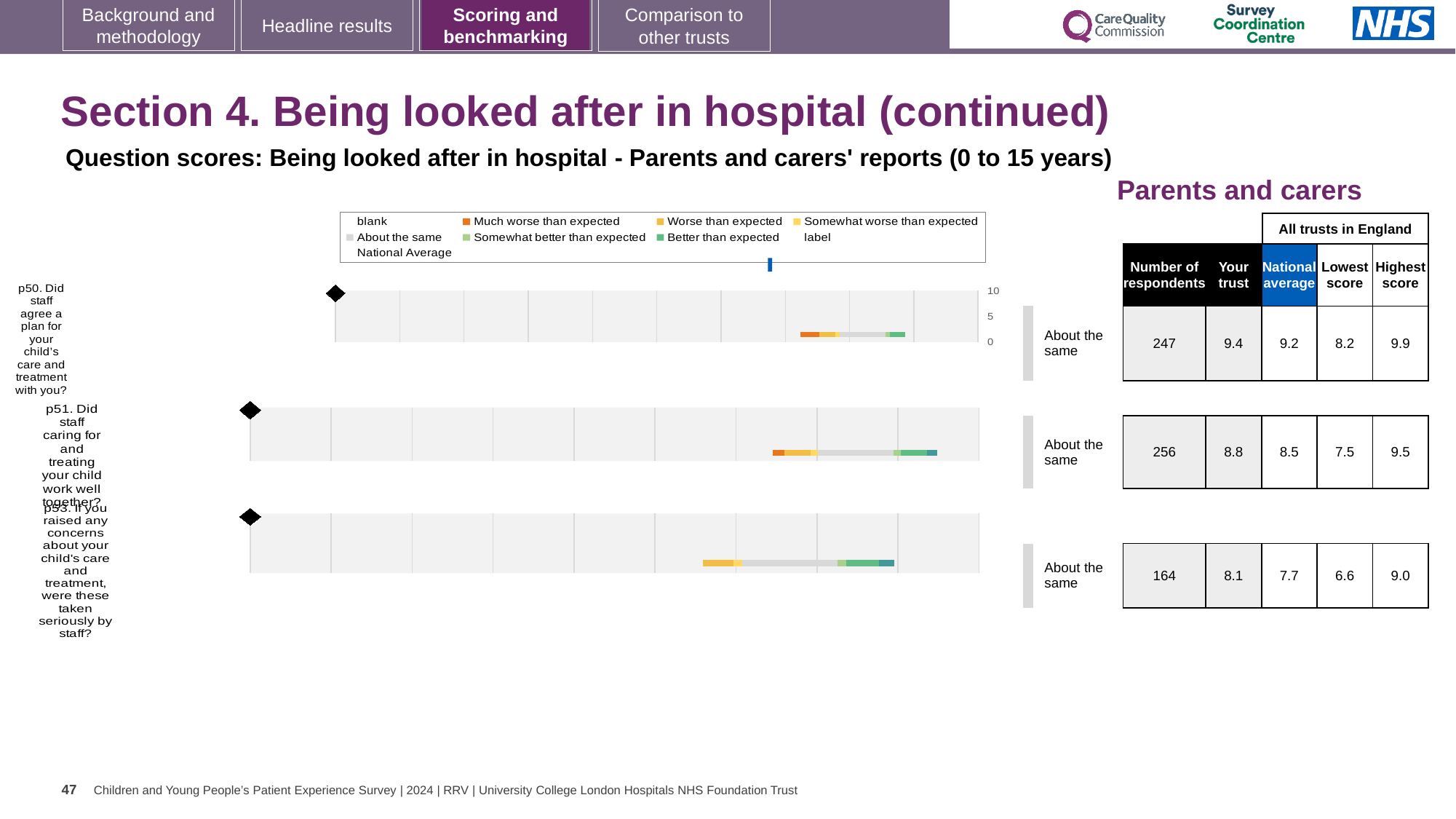
For the p50 chart, what is the highest score among all trusts in England? 9.9 What kind of chart is used for each question on the slide? Bar chart For the p53 chart (If you raised any concerns about your child's care and treatment, were these taken seriously by staff?), what is the number of respondents? 164 Which of the three questions has the highest 'Your trust' score? p50 For the p53 chart, what is the lowest score among all trusts in England? 6.6 For the p51 chart, which is larger: the 'Your trust' score or the national average? Your trust What benchmark category is shown next to the p51 chart? About the same For the p50 chart (Did staff agree a plan for your child's care and treatment with you?), what is the 'Your trust' score? 9.4 For the p51 chart (Did staff caring for and treating your child work well together?), what is the national average score? 8.5 Which of the three questions has the lowest number of respondents? p53 How many question charts are shown on the slide? 3 For the p53 chart, what is the difference between the 'Your trust' score and the national average? 0.4